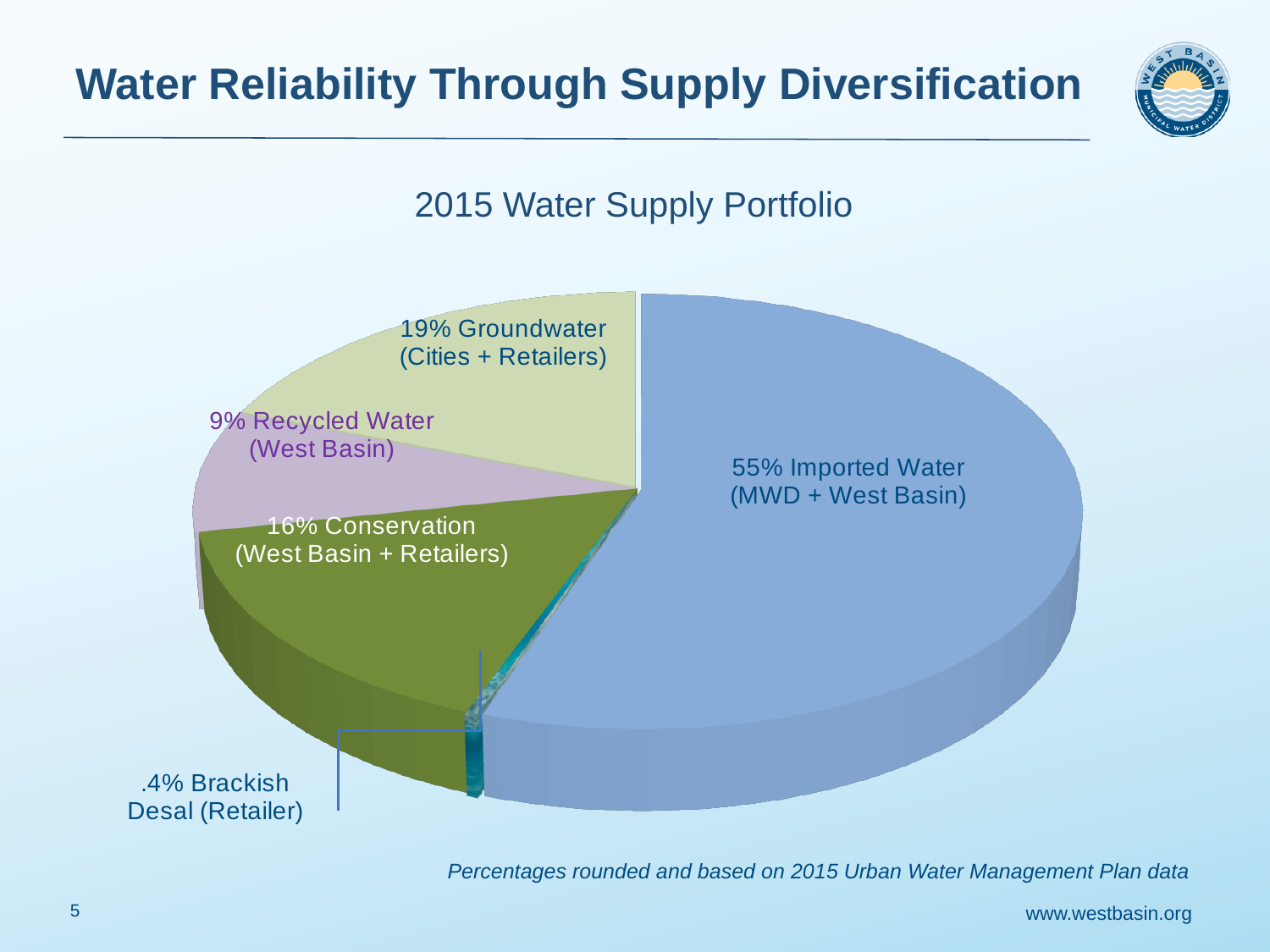
What is the title of the pie chart on the slide? 2015 Water Supply Portfolio Which slice of the 2015 Water Supply Portfolio pie is the smallest? Brackish Desal (Retailer) What share of the 2015 Water Supply Portfolio is Conservation (West Basin + Retailers)? 16% What share of the 2015 Water Supply Portfolio is Imported Water (MWD + West Basin)? 55% Which is larger in the 2015 Water Supply Portfolio: Groundwater or Conservation? Groundwater What is the difference in percentage points between Imported Water and Groundwater in the 2015 Water Supply Portfolio? 36% What share of the 2015 Water Supply Portfolio is Groundwater (Cities + Retailers)? 19% What kind of chart is shown on the slide? Pie chart Which slice of the 2015 Water Supply Portfolio pie is the largest? Imported Water (MWD + West Basin) How many slices does the 2015 Water Supply Portfolio pie chart have? 5